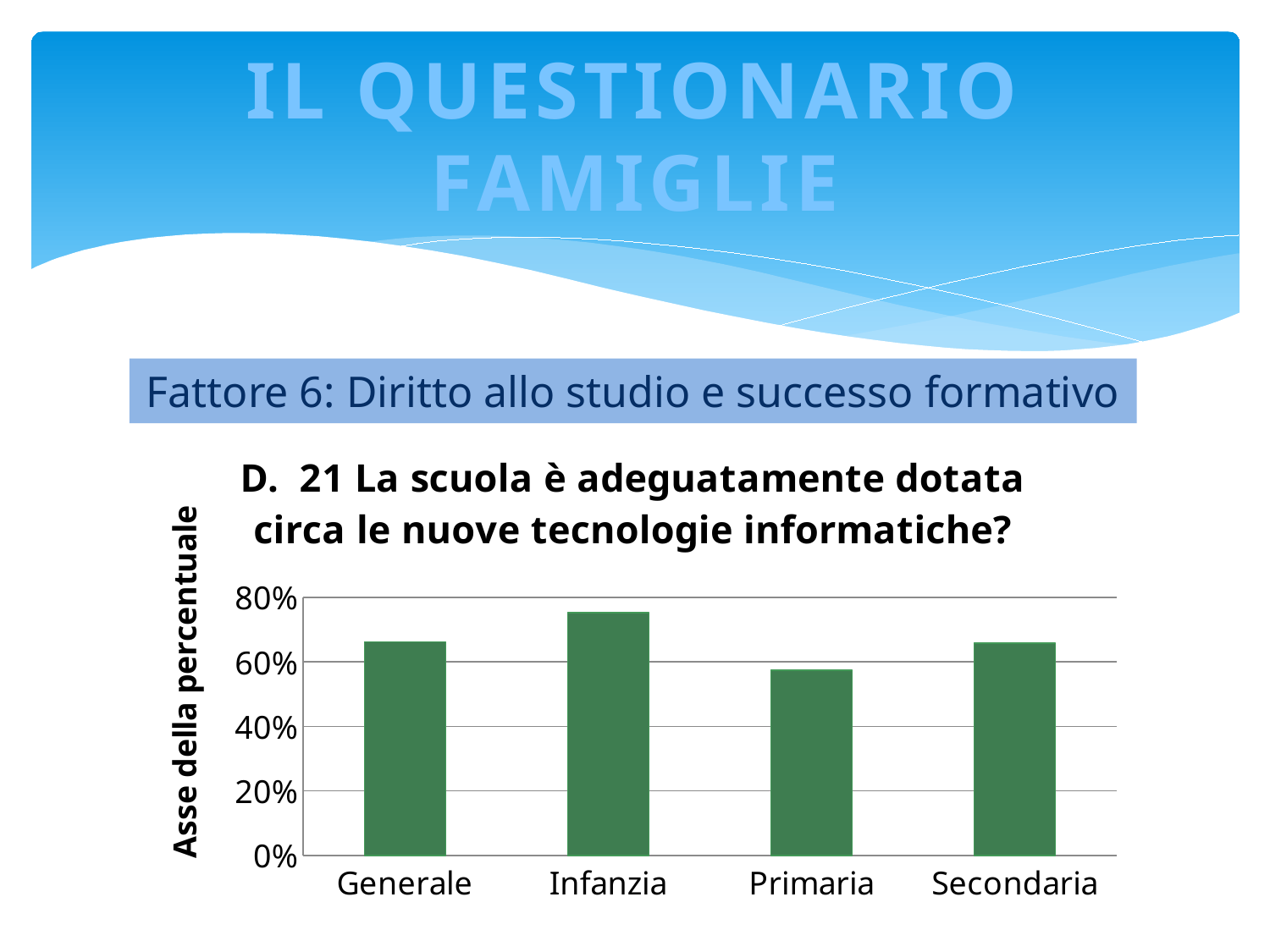
How many categories are shown on the x axis of the chart? 4 Is the value for Secondaria greater or less than 80%? less Is the value for Infanzia greater or less than 60%? greater Is the value for Generale greater or less than 60%? greater What is the label of the vertical axis of the chart? Asse della percentuale Which is larger, the value for Infanzia or the value for Primaria? Infanzia What kind of chart is shown on the slide? bar chart What is the title of the chart? D. 21 La scuola è adeguatamente dotata circa le nuove tecnologie informatiche? Which category has the lowest value in the chart? Primaria Which category has the highest value in the chart? Infanzia Which is larger, the value for Secondaria or the value for Primaria? Secondaria